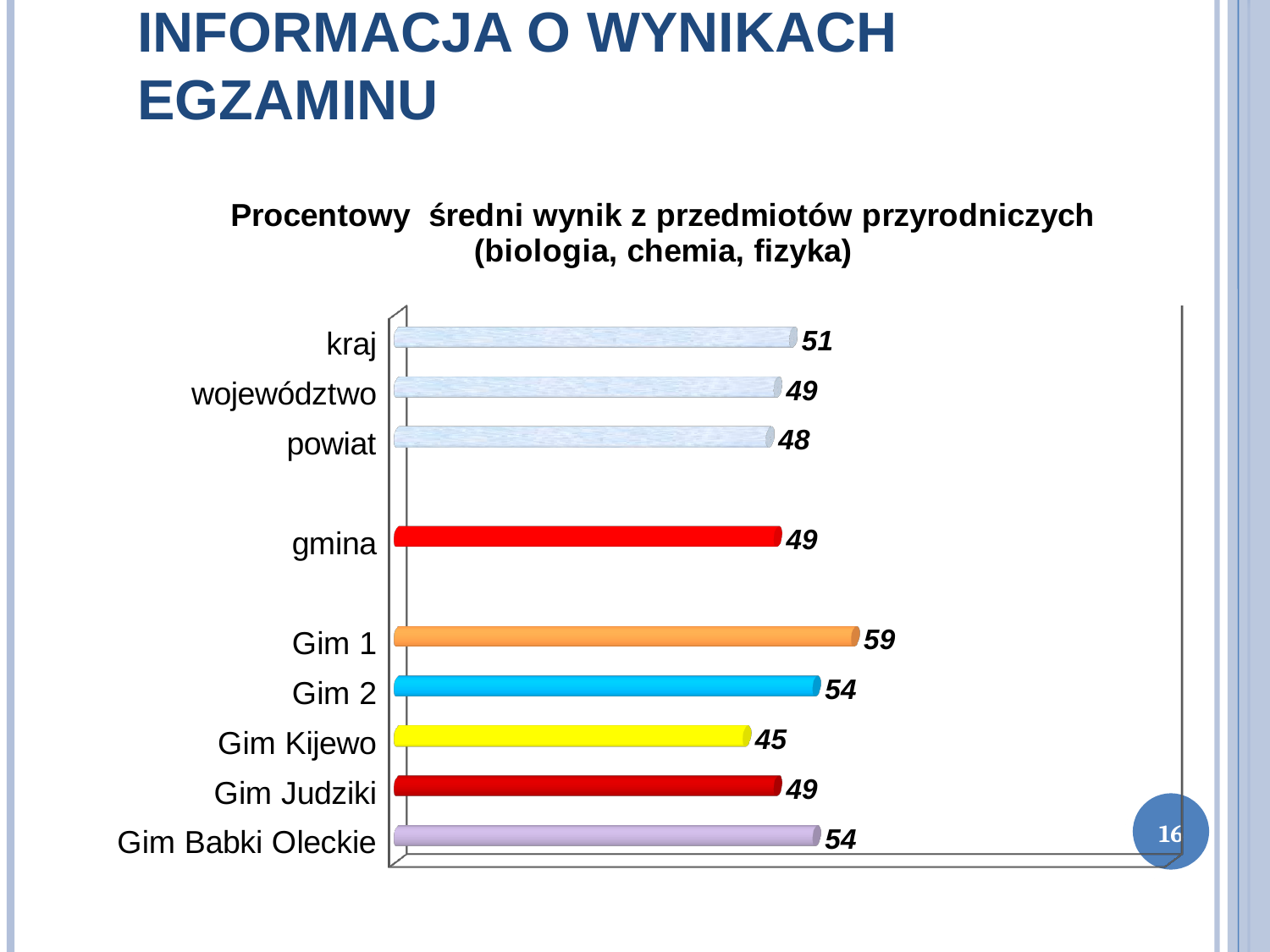
How many categories are shown in the chart? 9 What is the value for Gim Kijewo? 45 Which is larger, the value for Gim 2 or the value for Gim Judziki? Gim 2 What is the value for Gim 1? 59 What is the difference between the values for kraj and powiat? 3 What is the title of the chart? Procentowy średni wynik z przedmiotów przyrodniczych (biologia, chemia, fizyka) Which category has the highest value? Gim 1 Which category has the lowest value? Gim Kijewo What is the value for kraj? 51 What is the value for powiat? 48 What is the difference between the values for Gim 1 and Gim Kijewo? 14 What kind of chart is shown on the slide? bar chart